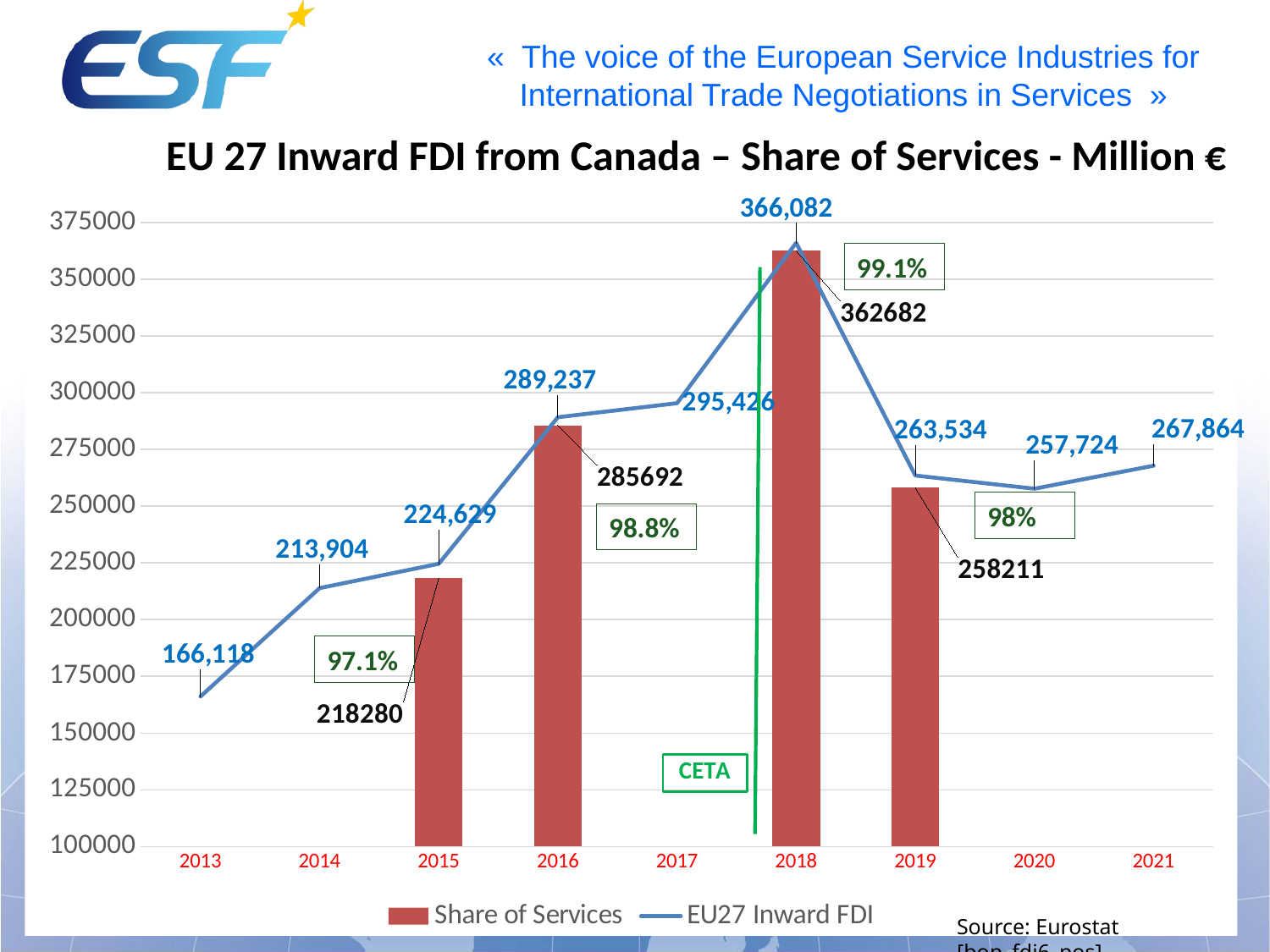
What is the Share of Services value for 2016? 285692 What is the EU27 Inward FDI value for 2013? 166,118 What is the difference between the EU27 Inward FDI values for 2018 and 2019? 102,548 In which year is the EU27 Inward FDI line at its highest? 2018 How many series does the legend list? 2 In which year is the EU27 Inward FDI line at its lowest? 2013 Does the EU27 Inward FDI line rise or fall from 2013 to 2018? rise Which is larger, the Share of Services bar for 2015 or for 2016? 2016 How many Share of Services bars are plotted on the chart? 4 What is the EU27 Inward FDI value for 2018? 366,082 What is the Share of Services value for 2019? 258211 What percentage is shown next to the 2018 Share of Services bar? 99.1%